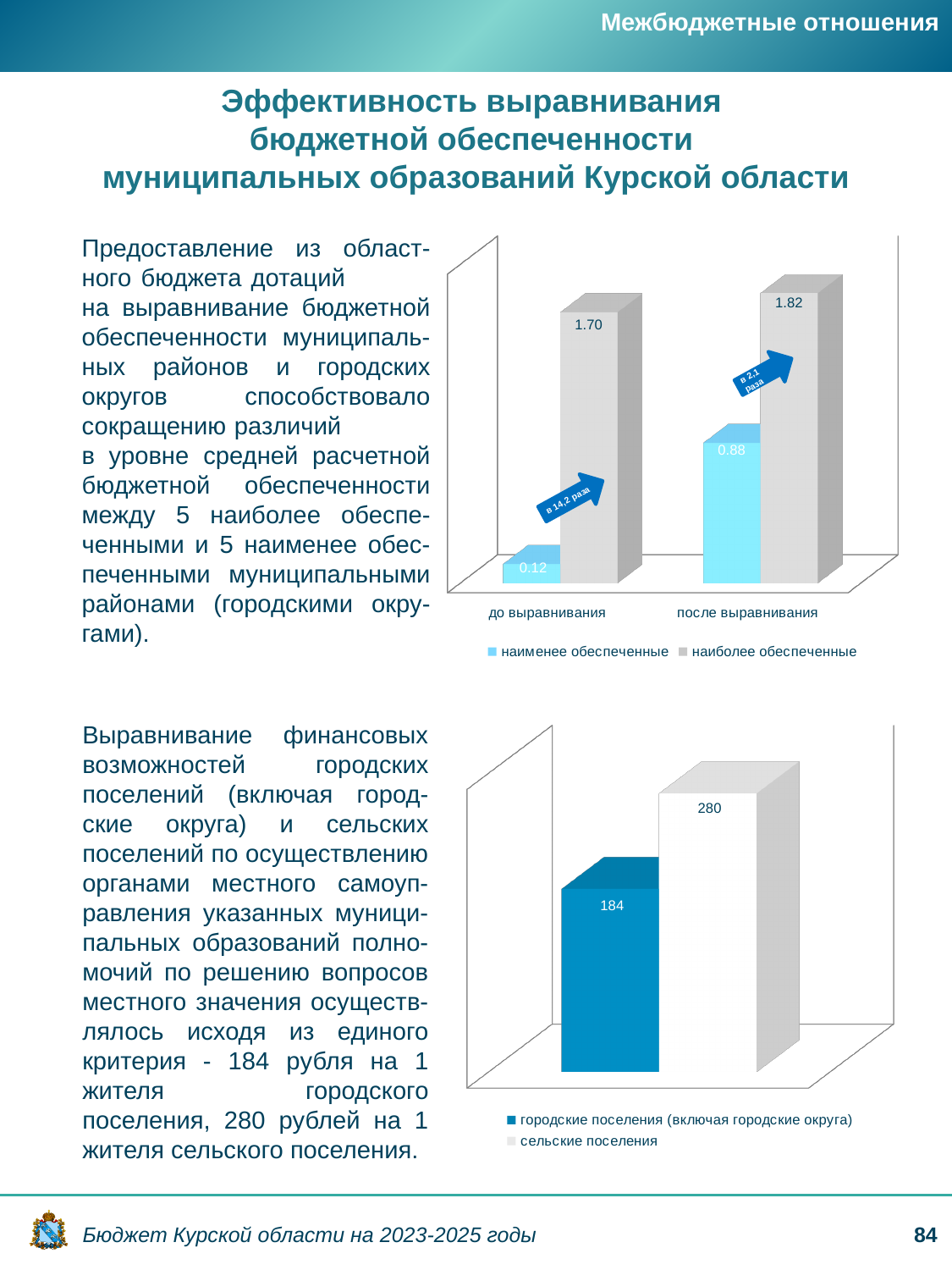
In the top chart, what is the value for 'наименее обеспеченные' in the 'до выравнивания' category? 0.12 In the top chart, what is the difference between 'наиболее обеспеченные' and 'наименее обеспеченные' in the 'до выравнивания' category? 1.58 In the top chart, does the value for 'наименее обеспеченные' rise or fall from 'до выравнивания' to 'после выравнивания'? rise In the top chart, what is the value for 'наиболее обеспеченные' in the 'после выравнивания' category? 1.82 In the top chart, what is the value for 'наименее обеспеченные' after equalisation ('после выравнивания')? 0.88 In the top chart, how many series does the legend list? 2 What kind of chart is the bottom chart? bar chart In the top chart, which is larger for 'наименее обеспеченные': the value 'до выравнивания' or 'после выравнивания'? после выравнивания In the bottom chart, what is the value for 'сельские поселения'? 280 In the top chart, how many categories are shown on the x axis? 2 In the bottom chart, what is the difference between 'сельские поселения' and 'городские поселения (включая городские округа)'? 96 In the bottom chart, what is the value for 'городские поселения (включая городские округа)'? 184